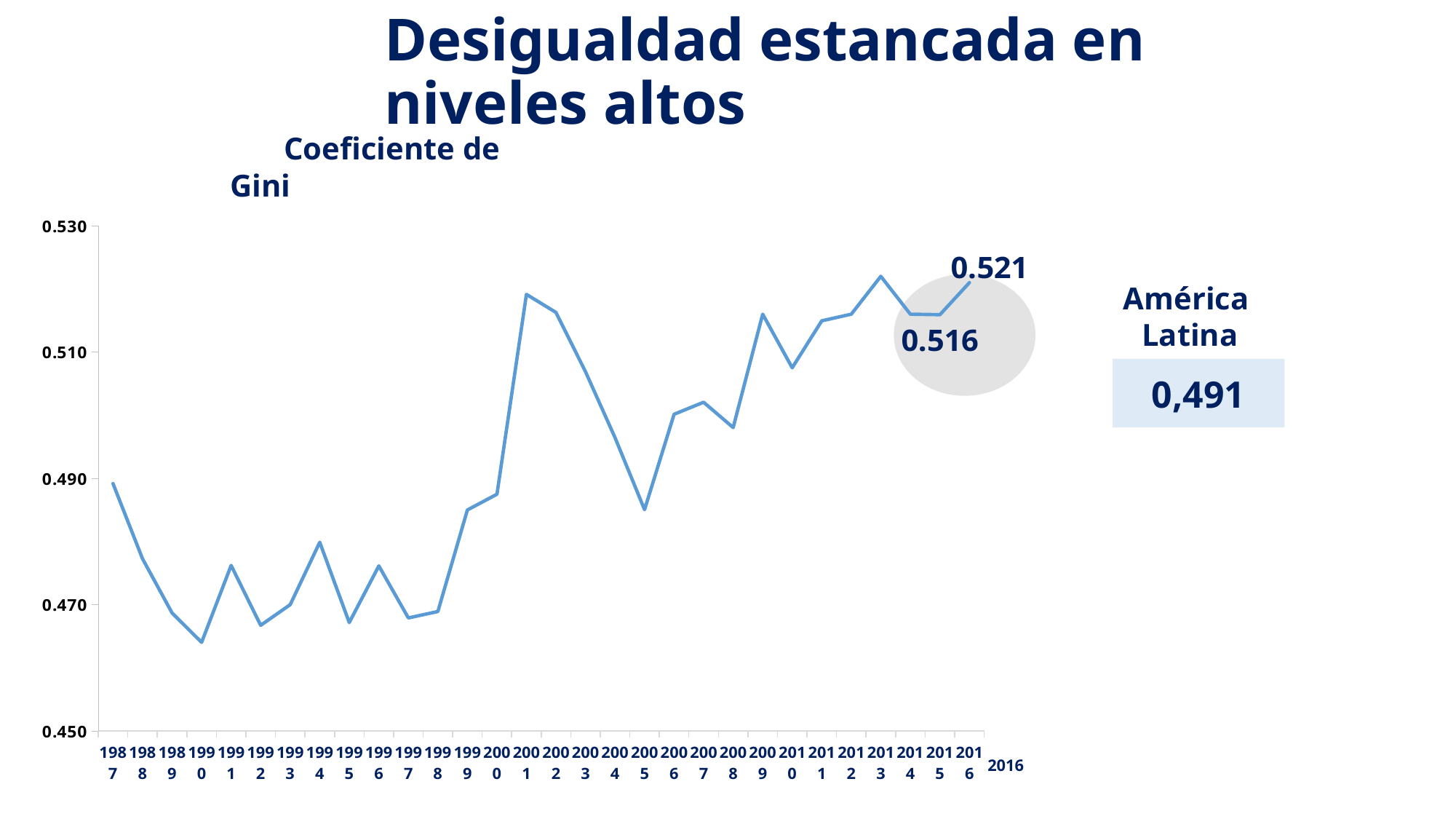
Overall, does the Gini coefficient rise or fall from 1987 to 2016? rise What value is printed inside the grey circle on the chart? 0.516 Which is larger, the value for 2005 or the value for 2009? 2009 What kind of chart is shown on the slide? line chart Is the value for 2001 greater or less than 0.510? greater How many years (data points) are plotted along the x axis? 30 Which is larger, the value for 2001 or the value for 1987? 2001 Is the value for 2005 greater or less than 0.490? less What value is shown for América Latina in the box to the right of the chart? 0,491 What is the Gini coefficient value labelled for 2016? 0.521 Is the value for 1990 greater or less than 0.470? less Which year has the lowest Gini coefficient on the chart? 1990